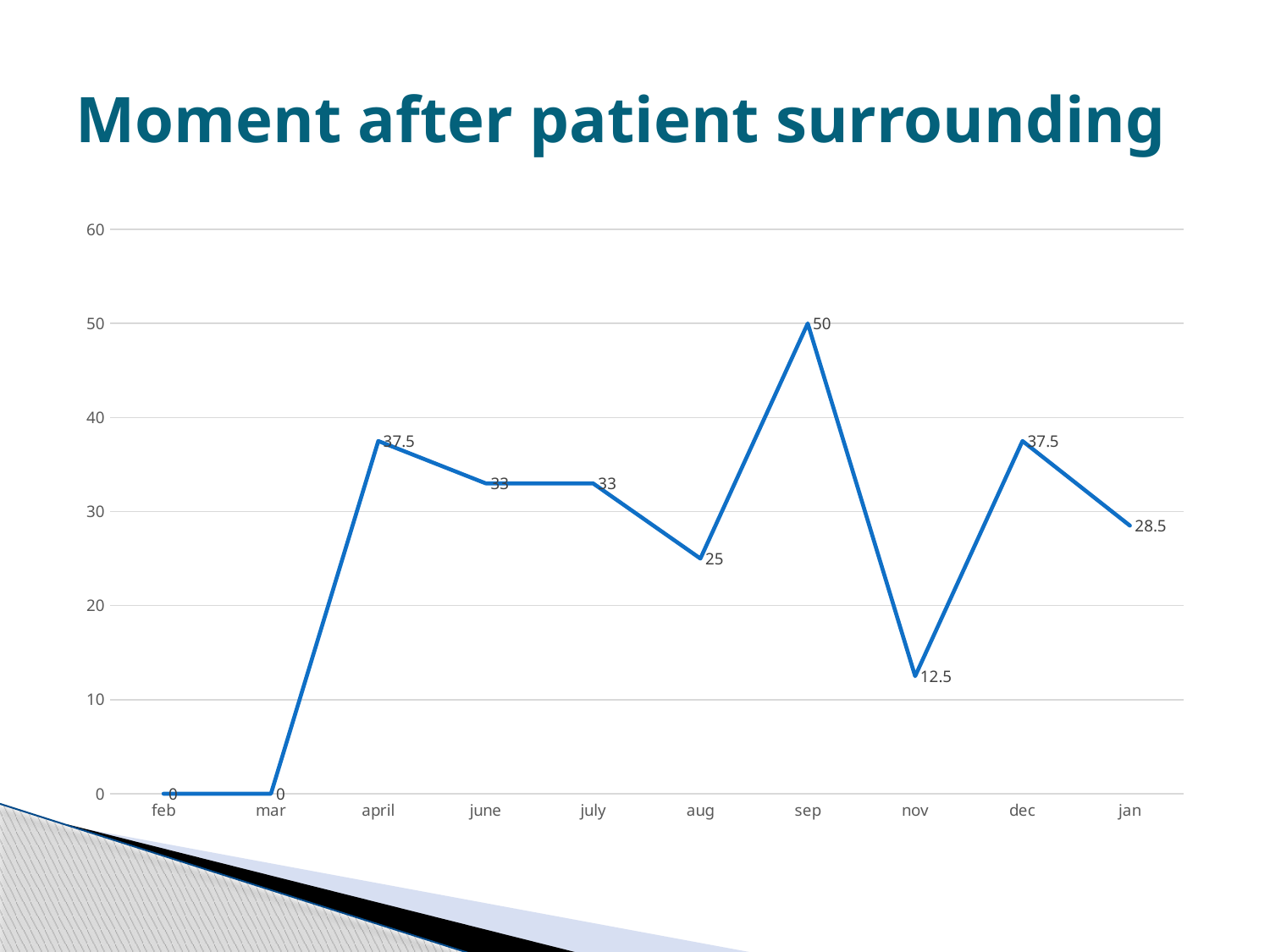
How many months are plotted on the x axis? 10 What is the value for jan? 28.5 What is the difference between the values for dec and jan? 9 What is the value for aug? 25 What is the value for nov? 12.5 Which is larger, the value for april or the value for aug? april Is the value for sep greater or less than 40? greater What is the title of the slide? Moment after patient surrounding Which month has the highest value? sep What is the value for sep? 50 What kind of chart is shown on the slide? line chart What is the difference between the values for sep and nov? 37.5